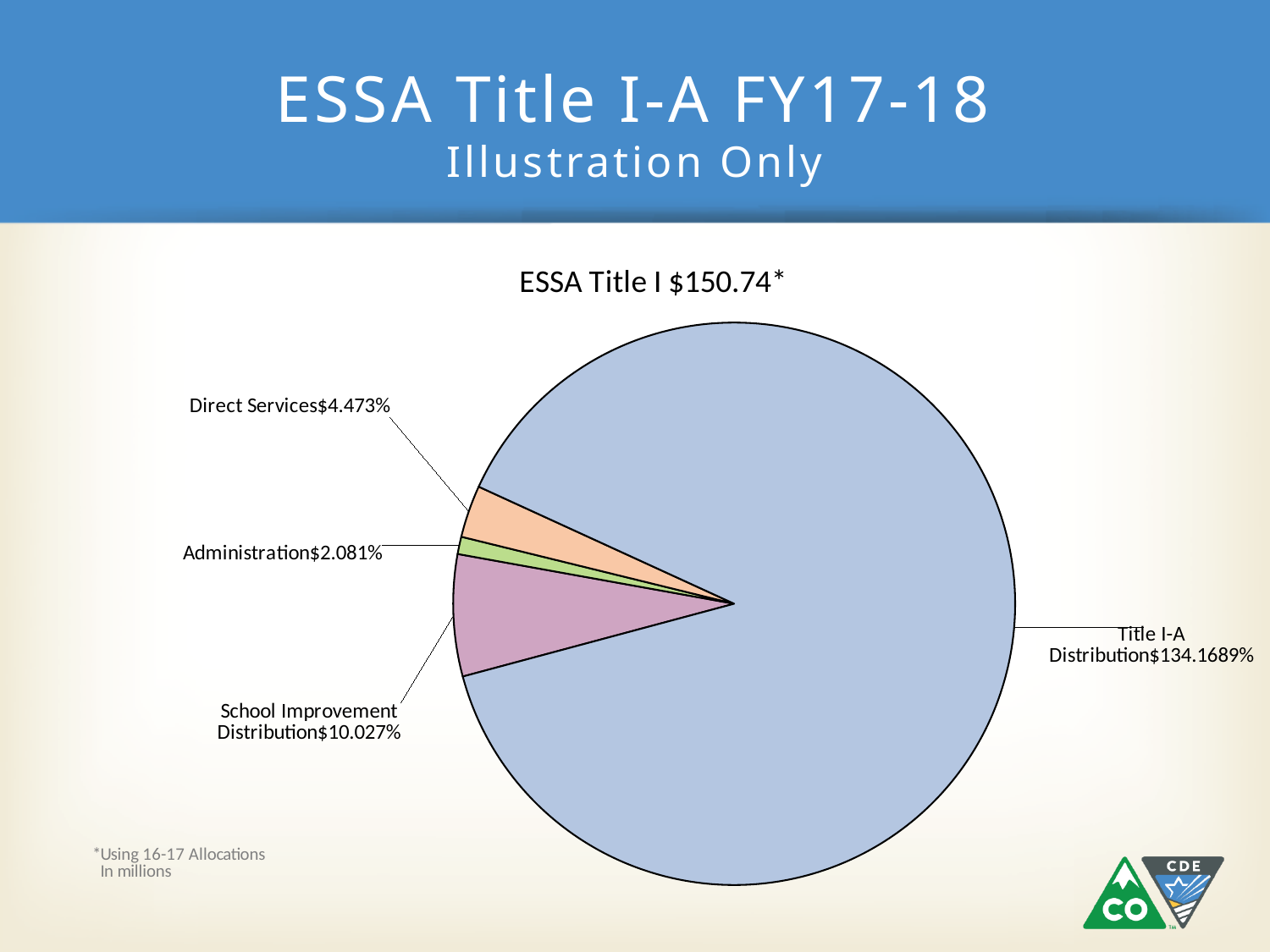
What value is labelled for Title I-A Distribution? $134.1689% What value is labelled for School Improvement Distribution? $10.027% How many slices does the pie chart have? 4 Which slice of the pie chart is the largest? Title I-A Distribution What value is labelled for Direct Services? $4.473% What is the title of the pie chart? ESSA Title I $150.74* Which is larger, Direct Services or Administration? Direct Services What value is labelled for Administration? $2.081% Which is larger, School Improvement Distribution or Direct Services? School Improvement Distribution Which slice of the pie chart is the smallest? Administration What kind of chart is shown on the slide? pie chart What colour is the Title I-A Distribution slice? light blue